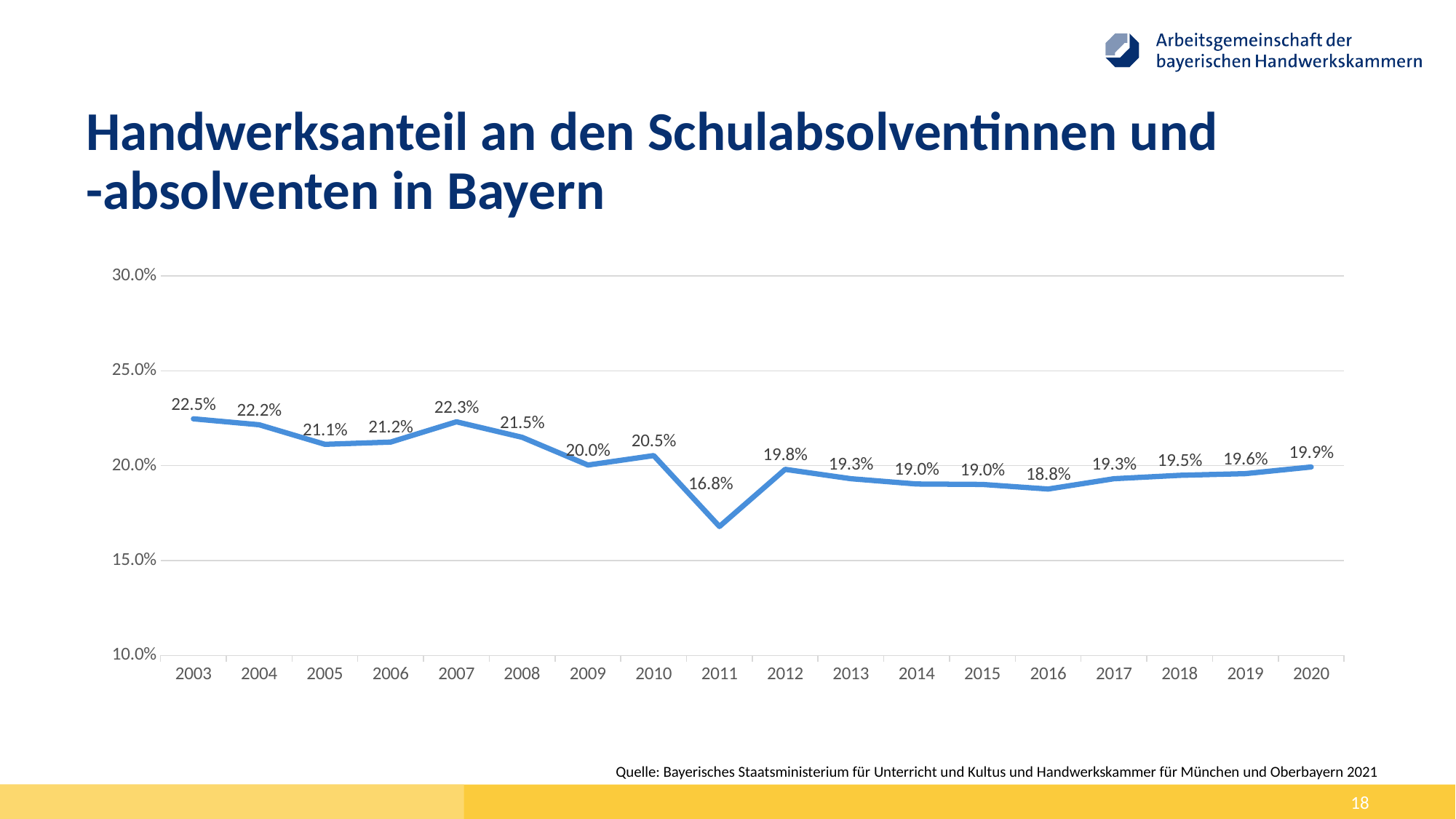
What is the difference between the values for 2003 and 2020? 2.6% What kind of chart is shown on the slide? Line chart What is the value for 2020? 19.9% What is the value for 2011? 16.8% Which year has the highest value? 2003 What is the value for 2007? 22.3% How many years are plotted on the x axis? 18 What is the difference between the values for 2010 and 2011? 3.7% What is the value for 2003? 22.5% Do the values rise or fall from 2016 to 2020? Rise Which is larger, the value for 2008 or the value for 2012? 2008 Which year has the lowest value? 2011